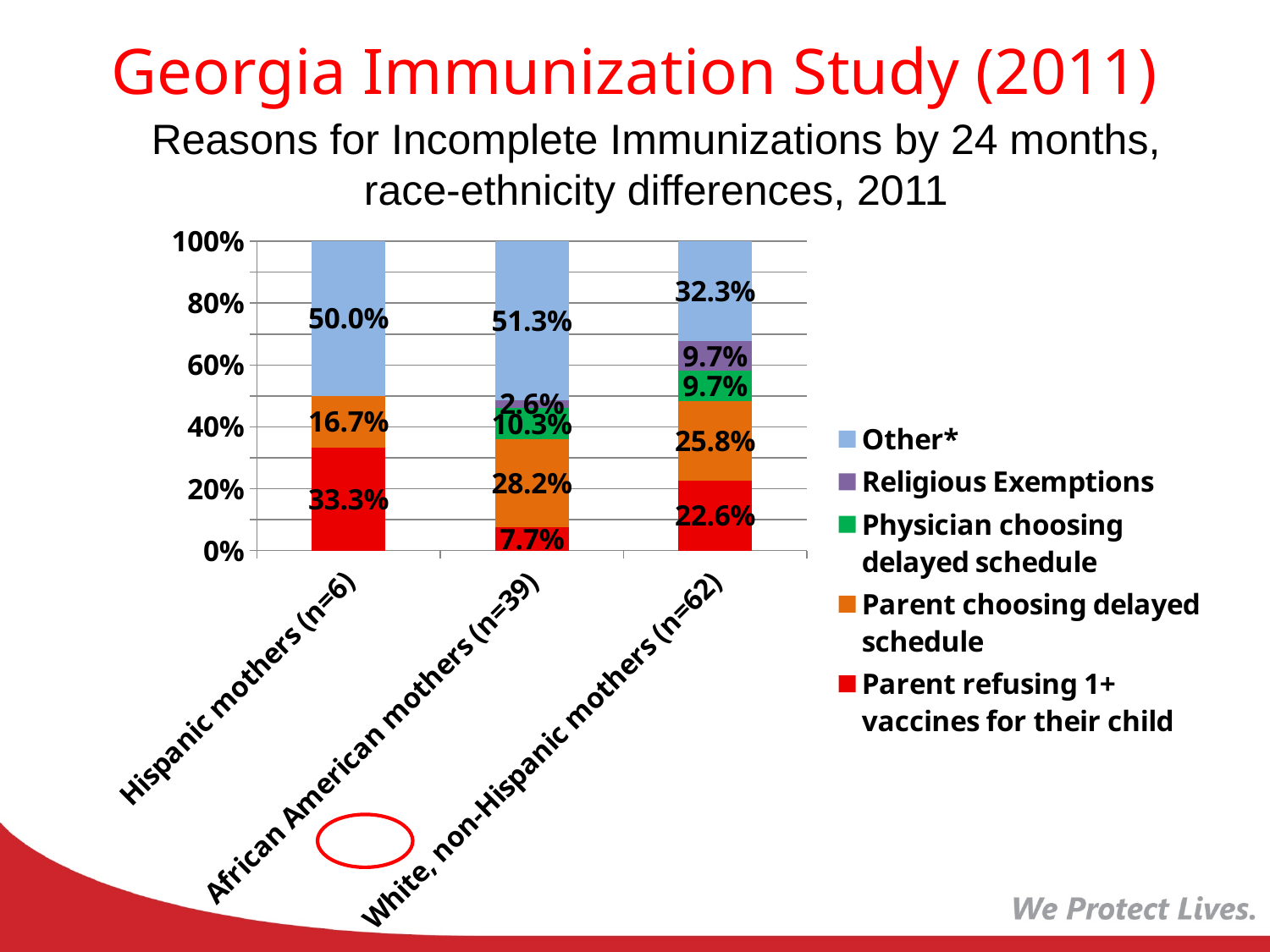
What is the value for 'Religious Exemptions' among White, non-Hispanic mothers (n=62)? 9.7% How many series does the legend list? 5 How many mother groups (categories) are shown on the x axis? 3 What colour represents 'Physician choosing delayed schedule' in the legend? Green Which is larger: 'Parent refusing 1+ vaccines for their child' for White, non-Hispanic mothers (n=62) or for African American mothers (n=39)? White, non-Hispanic mothers (n=62) What is the value for 'Other*' among African American mothers (n=39)? 51.3% Which mother group has the highest value for 'Parent refusing 1+ vaccines for their child'? Hispanic mothers (n=6) What is the value for 'Parent refusing 1+ vaccines for their child' among Hispanic mothers (n=6)? 33.3% What kind of chart is shown on the slide? Stacked bar chart What is the value for 'Parent choosing delayed schedule' among African American mothers (n=39)? 28.2% What is the difference between the 'Parent choosing delayed schedule' values for African American mothers (n=39) and Hispanic mothers (n=6)? 11.5% Which mother group has the lowest value for 'Other*'? White, non-Hispanic mothers (n=62)